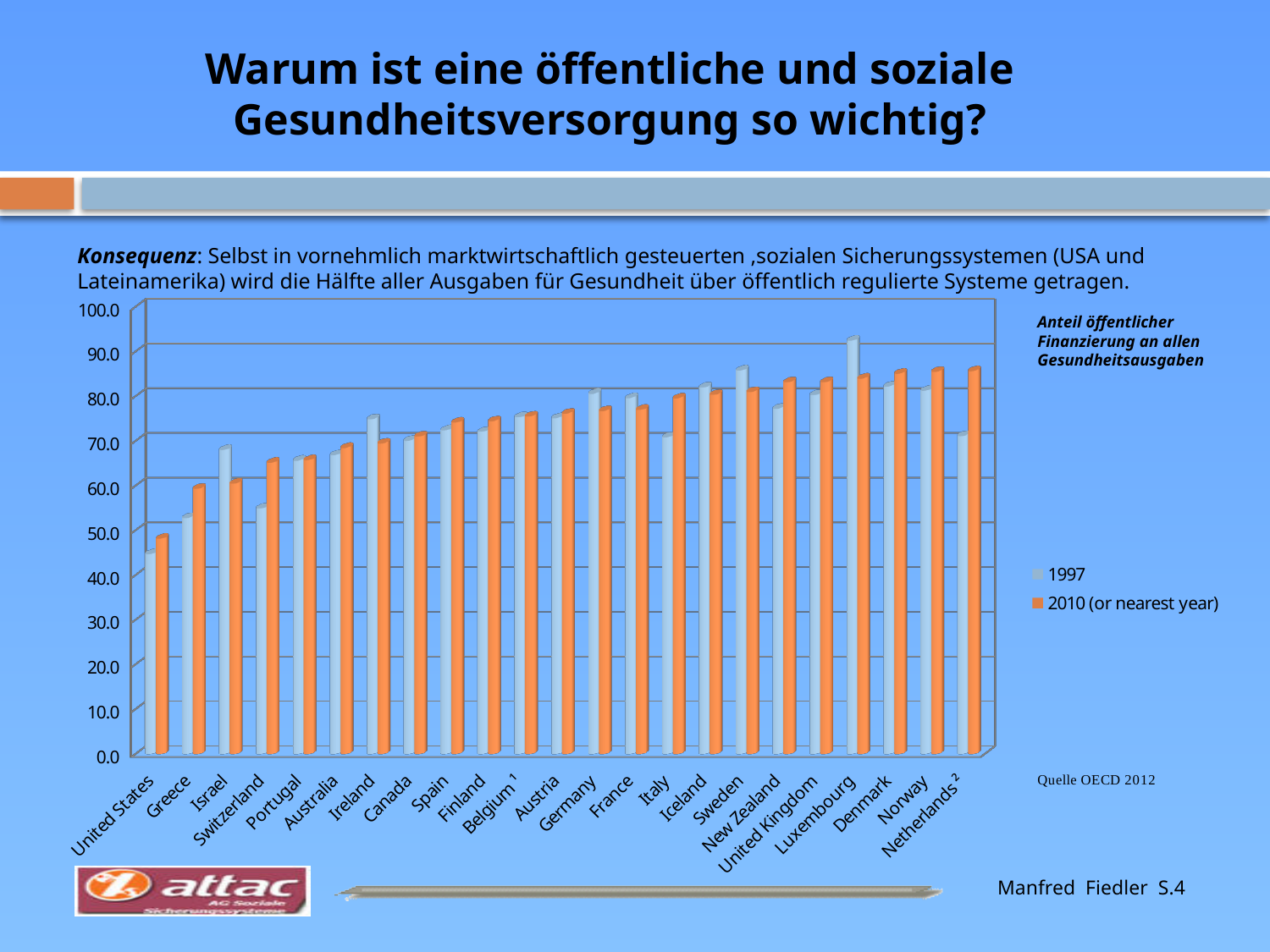
Which country has the lowest value for the 1997 series? United States How many countries are shown on the x axis of the chart? 23 Is the 2010 (or nearest year) value for the Netherlands greater or less than 80? greater What are the two legend entries of the chart? 1997 and 2010 (or nearest year) How many series does the chart legend list? 2 Do the values of the 2010 (or nearest year) series generally rise or fall from left to right along the x axis? Rise What kind of chart is shown on the slide? Bar chart For Switzerland, which is larger: the 1997 value or the 2010 (or nearest year) value? 2010 (or nearest year) Is the 1997 value for the United States greater or less than 50? less Which country has the highest value for the 1997 series? Luxembourg Which country has the lowest value for the 2010 (or nearest year) series? United States Is the 1997 value for Luxembourg greater or less than 90? greater